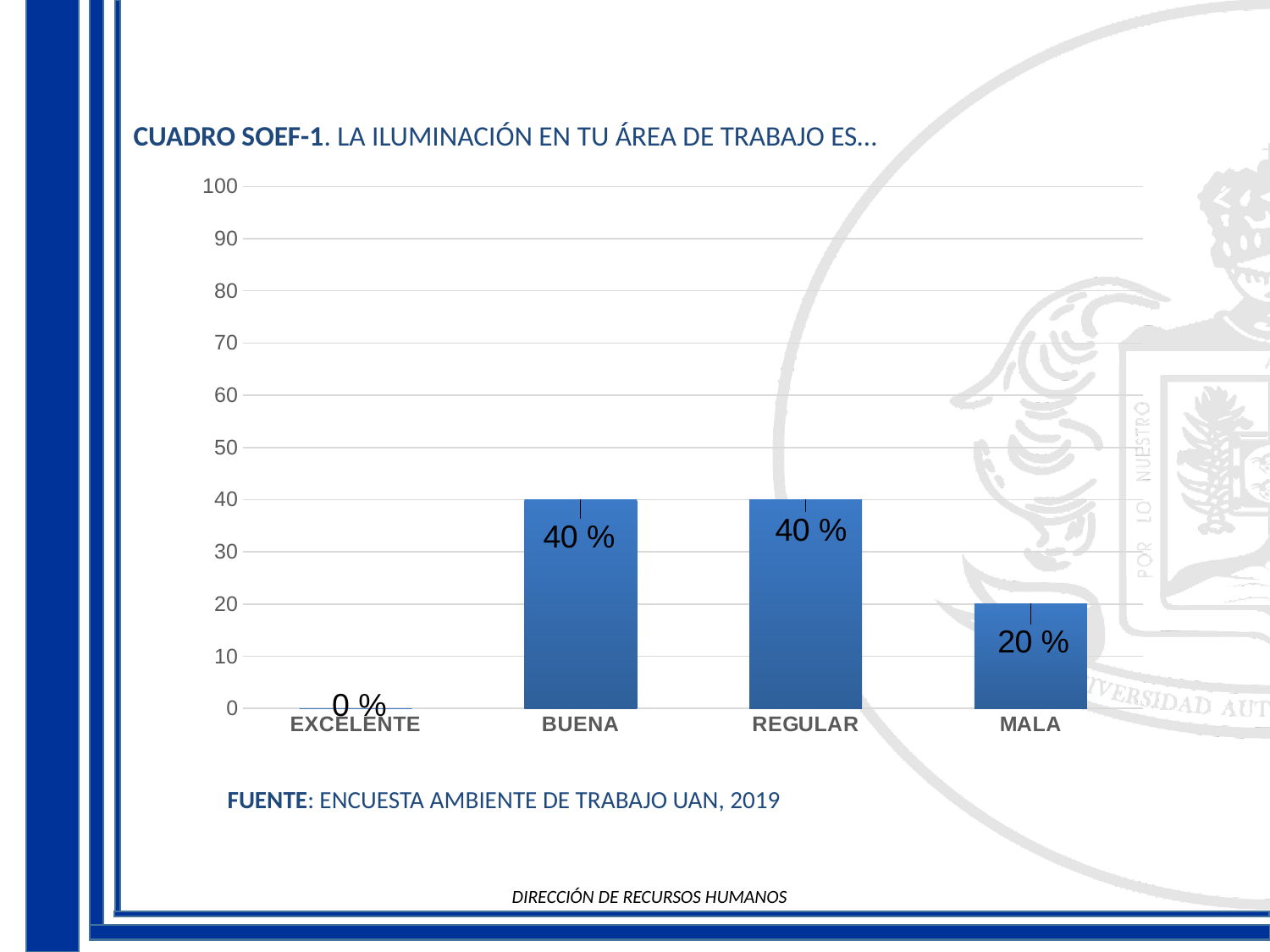
How many categories are shown on the x axis? 4 Which is larger, the value for BUENA or the value for MALA? BUENA What kind of chart is shown on the slide? bar chart What is the value for MALA? 20 % Which category has the lowest value? EXCELENTE What is the value for EXCELENTE? 0 % Is the value for MALA greater or less than 30? less What is the source cited below the chart? ENCUESTA AMBIENTE DE TRABAJO UAN, 2019 What is the title of the chart? CUADRO SOEF-1. LA ILUMINACIÓN EN TU ÁREA DE TRABAJO ES… What is the value for REGULAR? 40 % What is the value for BUENA? 40 % What is the difference between the values for REGULAR and MALA? 20 %